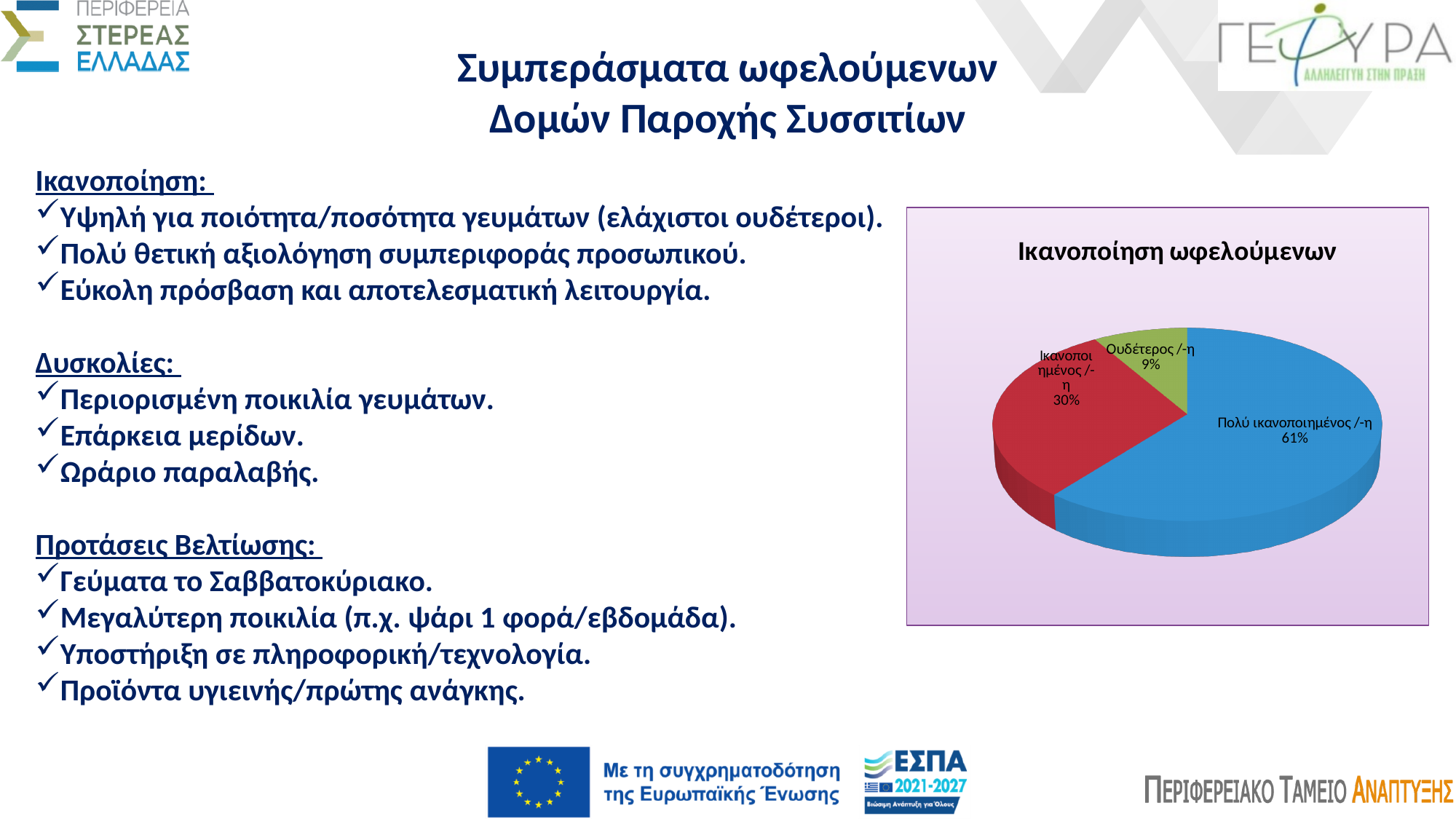
Which category has the largest slice in the pie chart? Πολύ ικανοποιημένος /-η How many categories are shown in the pie chart? 3 What share of the pie does the 'Ικανοποιημένος /-η' slice represent? 30% What colour is the 'Πολύ ικανοποιημένος /-η' slice? Blue What kind of chart is shown on the slide? Pie chart What is the title of the chart? Ικανοποίηση ωφελούμενων Which is larger: the 'Ικανοποιημένος /-η' slice or the 'Ουδέτερος /-η' slice? Ικανοποιημένος /-η What is the difference in percentage points between the 'Πολύ ικανοποιημένος /-η' and 'Ικανοποιημένος /-η' slices? 31 What share of the pie does the 'Πολύ ικανοποιημένος /-η' slice represent? 61% What share of the pie does the 'Ουδέτερος /-η' slice represent? 9% What is the combined share of the 'Πολύ ικανοποιημένος /-η' and 'Ικανοποιημένος /-η' slices? 91% Which category has the smallest slice in the pie chart? Ουδέτερος /-η